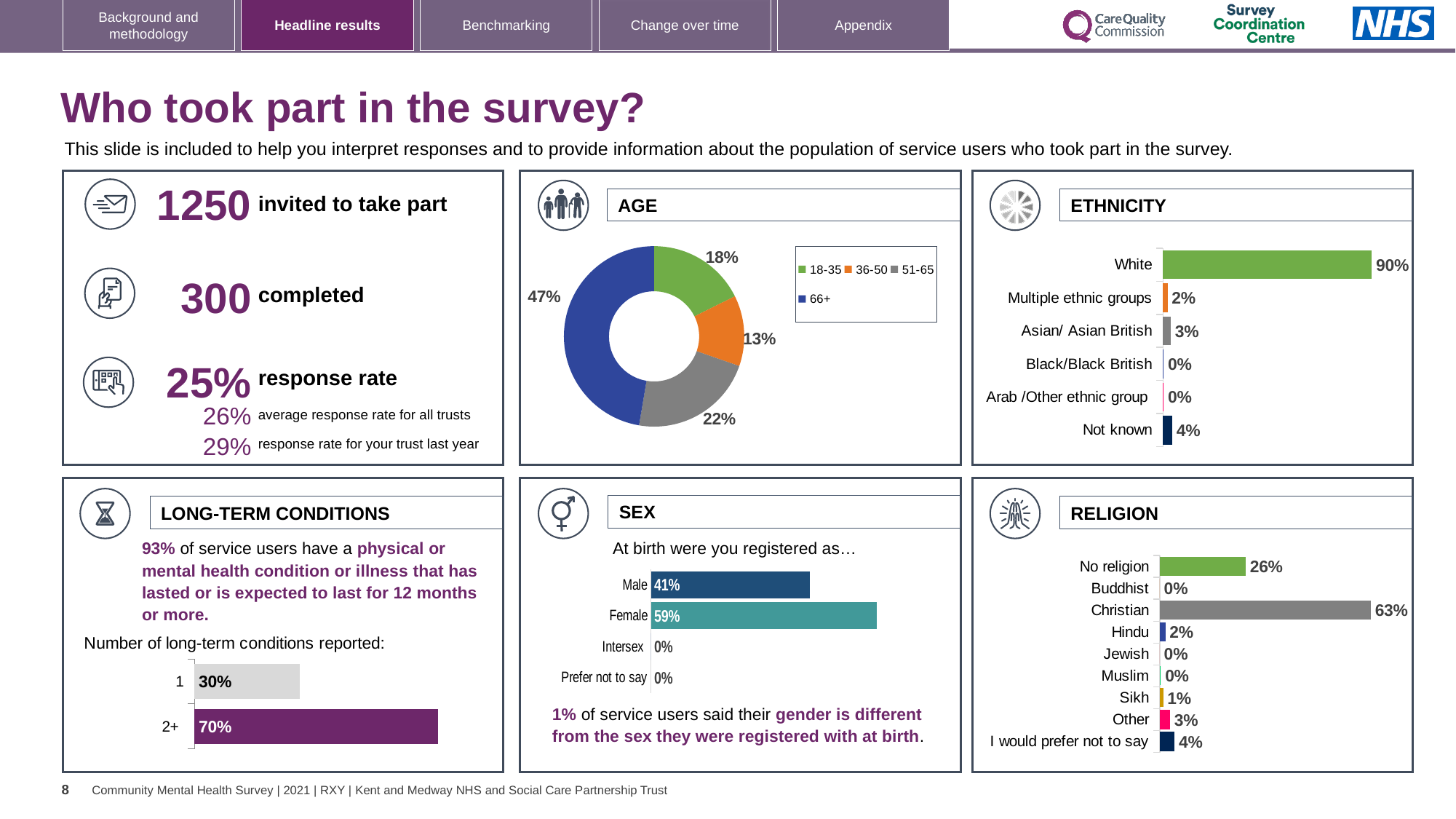
How many categories are shown in the RELIGION chart? 9 In the ETHNICITY chart, what is the value for Asian/ Asian British? 3% In the ETHNICITY chart, which category has the highest value? White How many categories are shown in the ETHNICITY chart? 6 What kind of chart is the AGE chart? Donut (pie) chart In the SEX chart, which is larger, Male or Female? Female How many entries does the legend of the AGE chart list? 4 In the ETHNICITY chart, what is the difference between White and Not known? 86% In the AGE chart, which age group has the smallest share? 36-50 In the RELIGION chart, what is the value for Christian? 63% In the AGE chart, what percentage of respondents were aged 66+? 47% In the LONG-TERM CONDITIONS chart, what percentage reported 2+ conditions? 70%